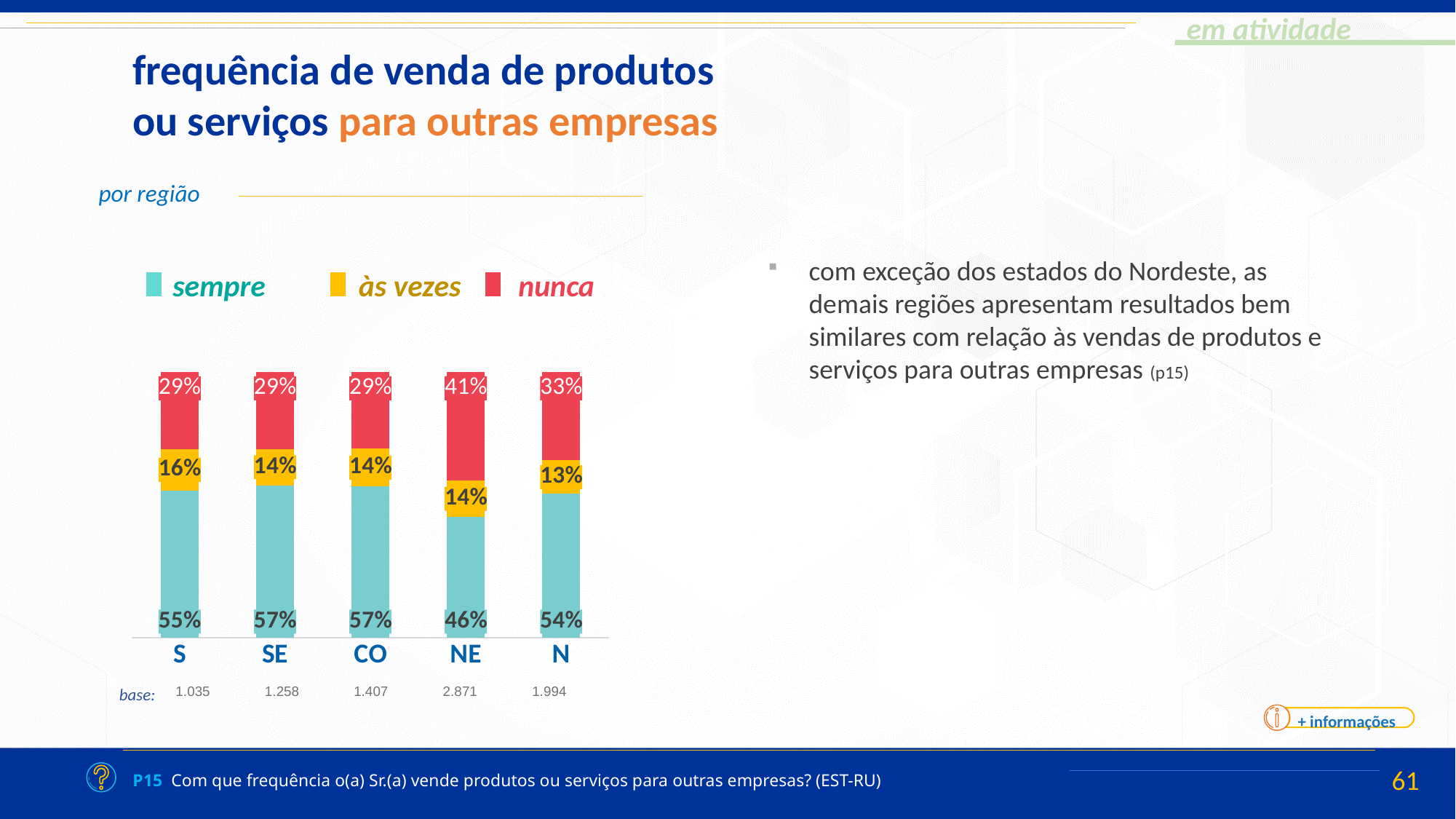
Which is larger, the "sempre" value for SE or for N? SE What is the total of the stacked bar for the CO region? 100% Which colour represents "nunca" in the chart? Red What is the "às vezes" value for the N region? 13% How many regions are shown on the x axis of the chart? 5 Which region has the highest "nunca" share? NE What is the difference between the "nunca" values for NE and S? 12 percentage points Which region has the lowest "sempre" share? NE What kind of chart is shown on the slide? Stacked bar chart What is the "sempre" value for the S region? 55% What percentage of respondents in the NE region answered "nunca"? 41% How many series does the legend list? 3